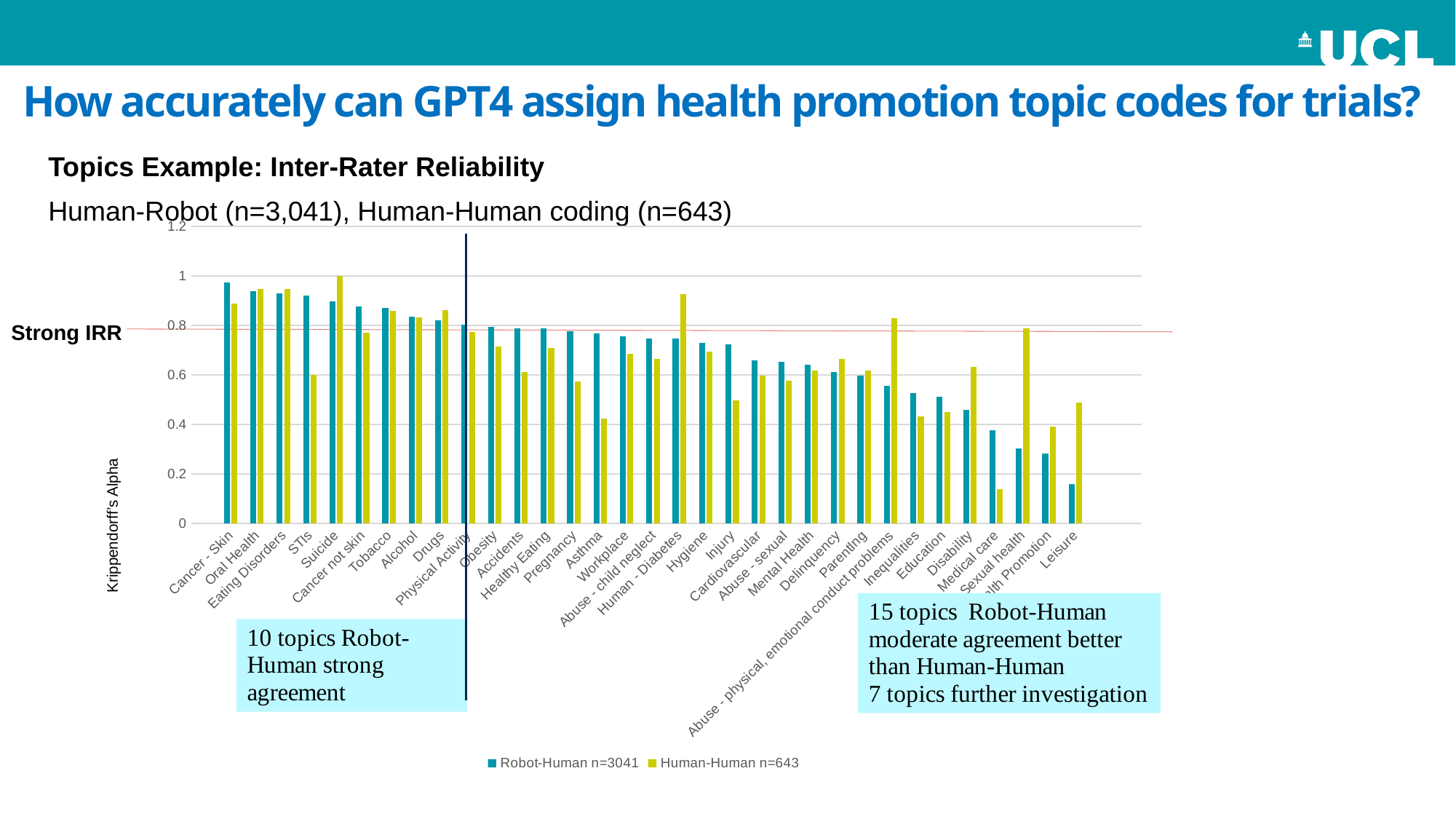
What kind of chart is shown on the slide? Bar chart What is the label on the vertical axis of the chart? Krippendorff's Alpha How many series does the chart's legend list? 2 What are the two series named in the legend? Robot-Human n=3041 and Human-Human n=643 Which topic has the highest Robot-Human value? Cancer - Skin For Human - Diabetes, which series has the larger value, Robot-Human or Human-Human? Human-Human Is the Robot-Human value for Leisure greater or less than 0.2? less Which topic has the lowest Human-Human value? Medical care Do the Robot-Human values generally rise or fall moving from left to right along the x axis? Fall Which topic has the lowest Robot-Human value? Leisure Is the Human-Human value for Asthma greater or less than 0.6? less Which topic has the highest Human-Human value? Suicide